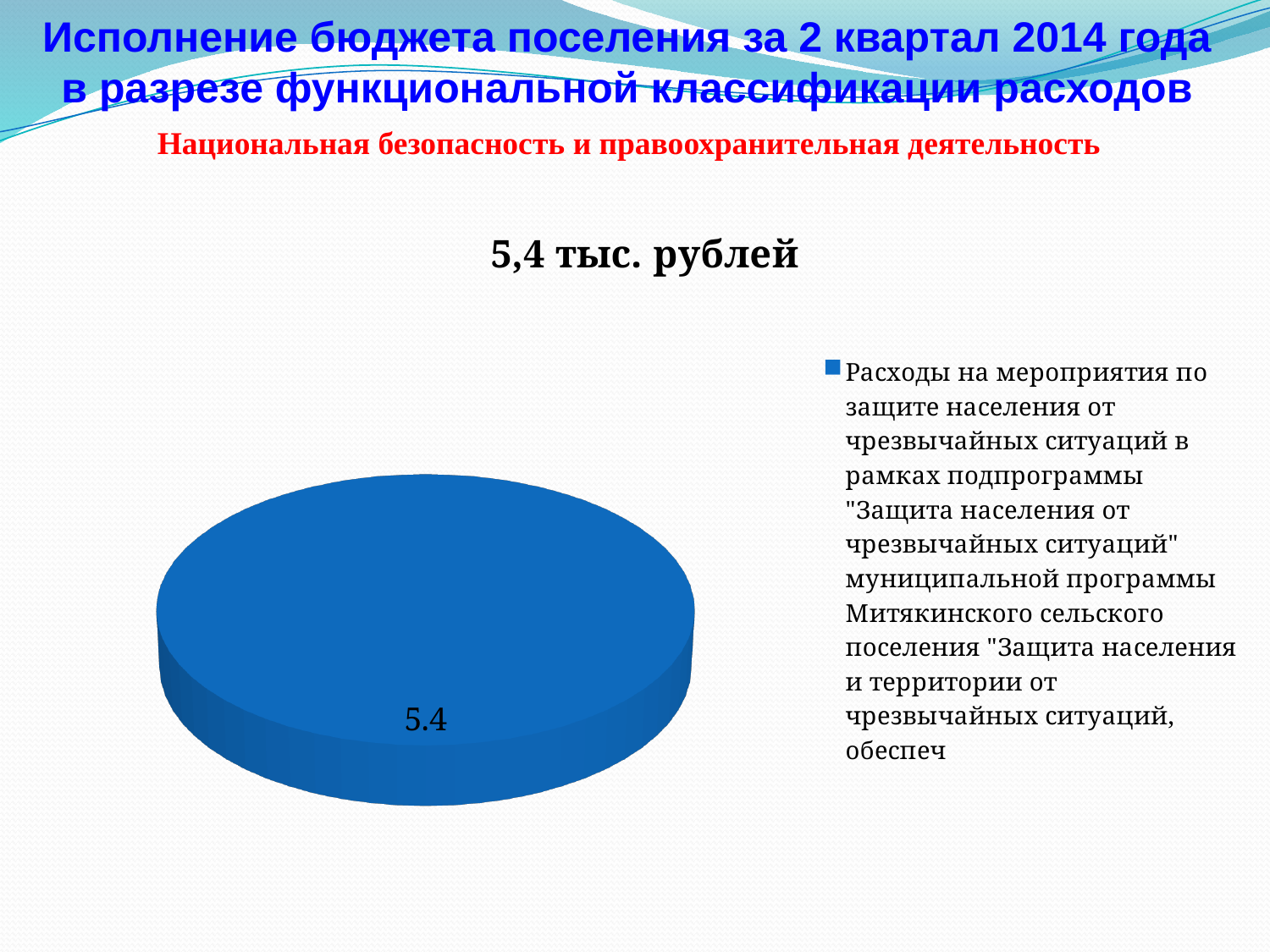
How many entries does the legend of the pie chart list? 1 Is the value printed on the pie chart's slice greater or less than 5? greater What colour is the slice of the pie chart? blue What kind of chart is shown on the slide? pie chart How many slices does the pie chart have? 1 What value is printed on the pie chart's slice? 5.4 What is the title shown above the pie chart? 5,4 тыс. рублей What share of the pie does the single slice take up? 100%